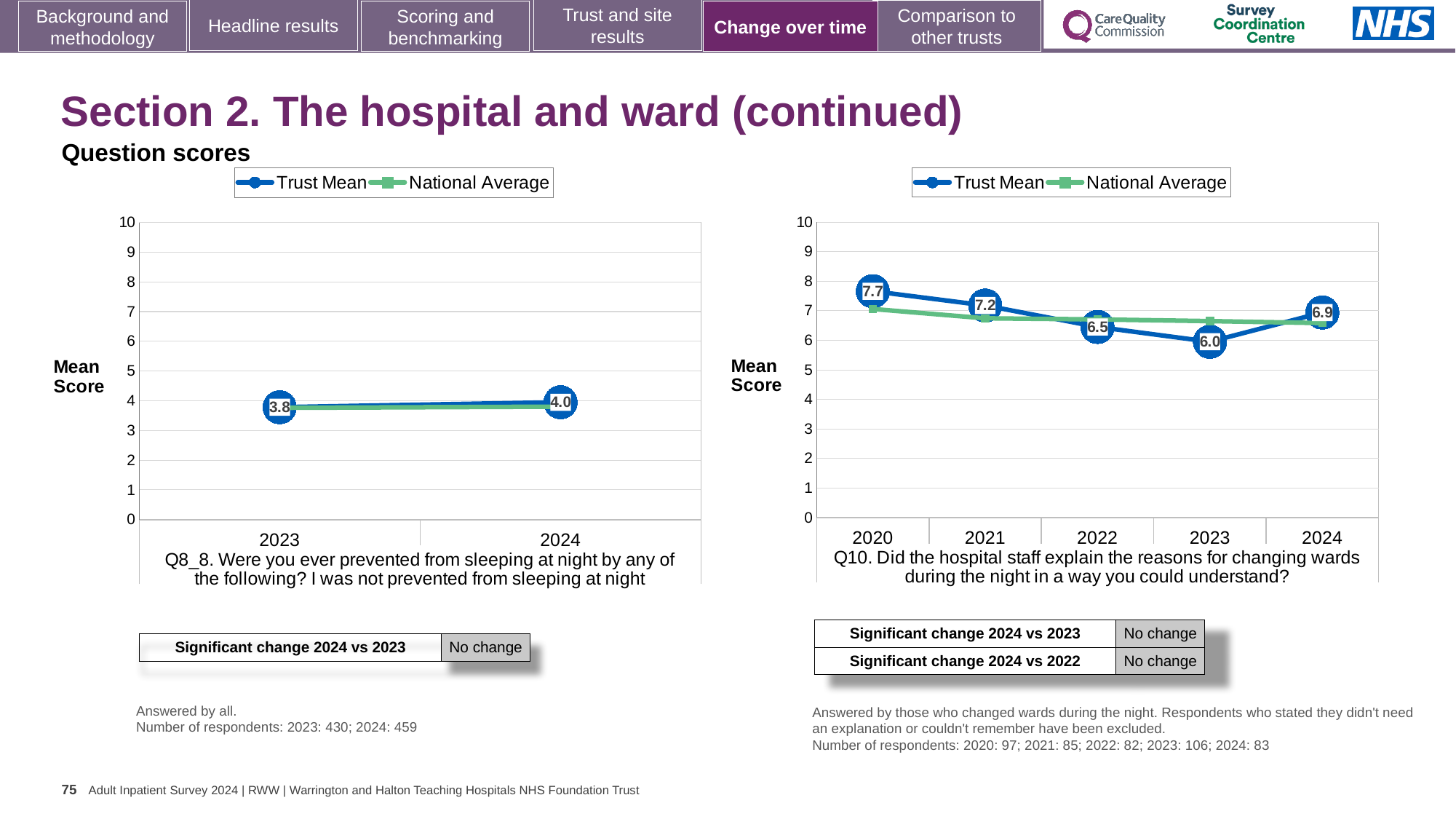
In the right chart (Q10), which year has the lowest Trust Mean score? 2023 What type of chart is the right chart (Q10)? line chart In the left chart (Q8_8), what is the Trust Mean score for 2024? 4.0 In the left chart (Q8_8), what is the difference between the Trust Mean scores for 2024 and 2023? 0.2 In the right chart (Q10), what is the Trust Mean score for 2020? 7.7 In the right chart (Q10), how many years are plotted on the x axis? 5 How many series does the legend of the left chart (Q8_8) list? 2 In the right chart (Q10), what is the difference between the Trust Mean scores for 2020 and 2023? 1.7 In the right chart (Q10), is the Trust Mean score for 2024 higher or lower than for 2023? higher In the right chart (Q10), which year has the highest Trust Mean score? 2020 In the right chart (Q10), what is the Trust Mean score for 2023? 6.0 In the left chart (Q8_8), what is the Trust Mean score for 2023? 3.8